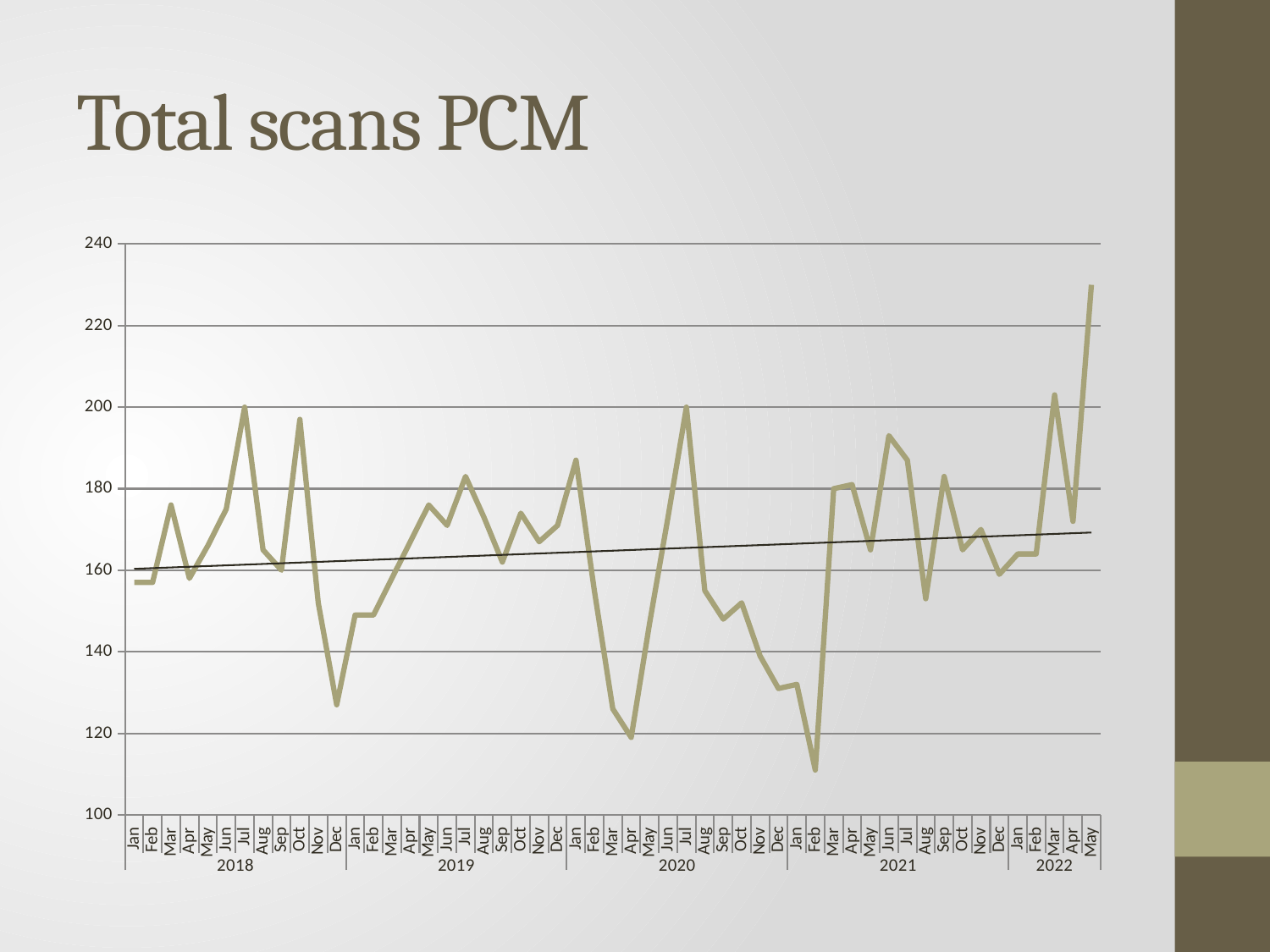
Which month has the lowest value on the chart? Feb 2021 What kind of chart is shown on the slide? line chart Is the value for Apr 2020 greater or less than 140? less Is the value for Dec 2018 greater or less than 140? less Does the straight trend line on the chart rise or fall from left to right? rise Is the value for Jun 2021 greater or less than 180? greater Which month has the highest value on the chart? May 2022 What is the title of the chart? Total scans PCM Which is larger, the value for Jul 2018 or the value for Dec 2018? Jul 2018 How many years are labelled along the x axis of the chart? 5